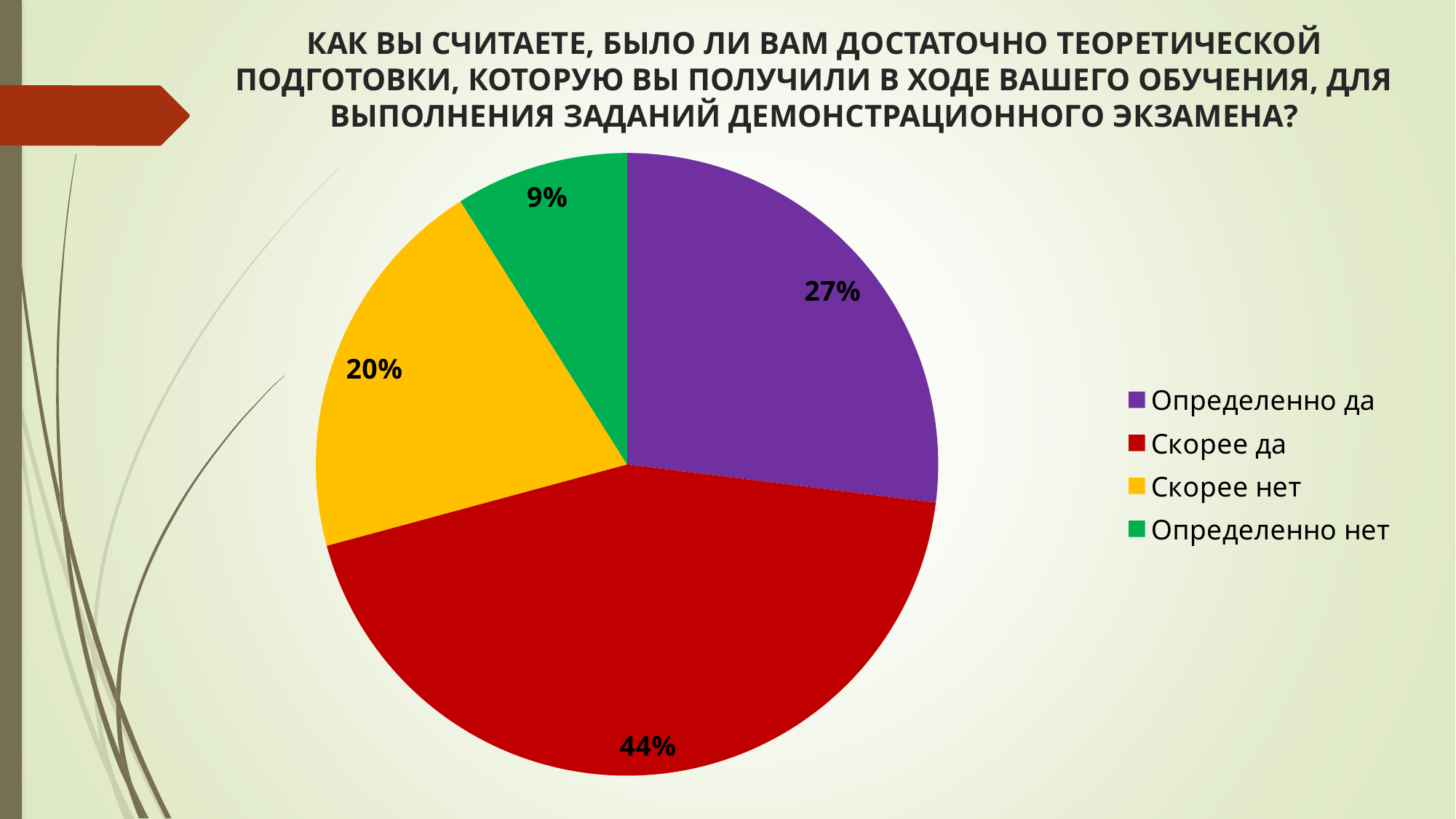
How many slices does the pie chart have? 4 Which category has the smallest slice of the pie? Определенно нет What colour is the slice for "Скорее нет"? yellow Which category has the largest slice of the pie? Скорее да What share of the pie does "Скорее нет" have? 20% What share of the pie does "Скорее да" have? 44% What type of chart is shown on the slide? pie chart What share of the pie does "Определенно нет" have? 9% What is the difference in percentage points between "Скорее да" and "Определенно да"? 17% Which is larger: the slice for "Скорее нет" or the slice for "Определенно нет"? Скорее нет How many entries does the legend list? 4